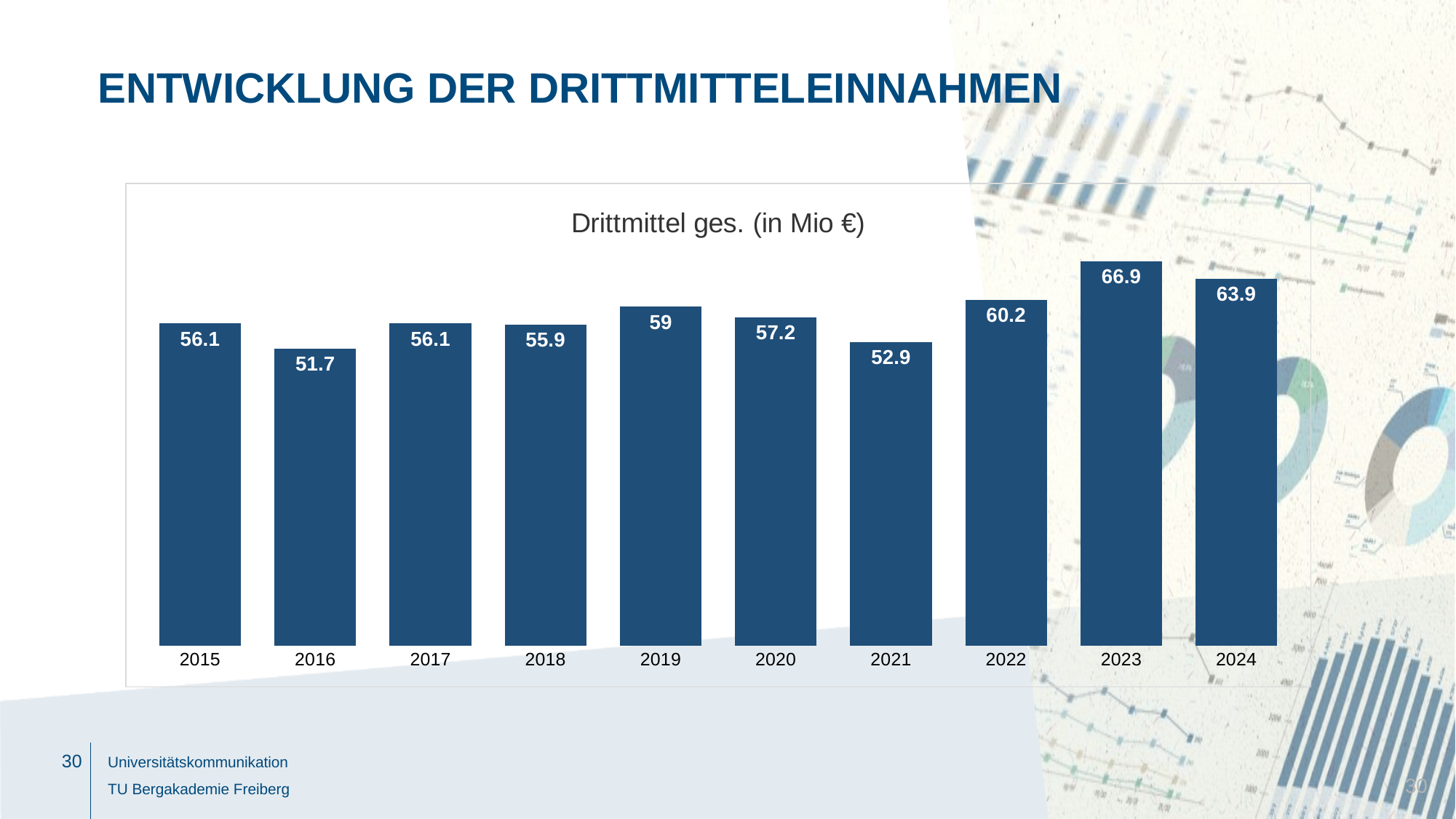
How many years are shown on the x axis? 10 Which year has the lowest value? 2016 Which year has the highest value? 2023 What kind of chart is shown? bar chart What is the value for 2016? 51.7 Do the values rise or fall from 2021 to 2023? rise What is the value for 2019? 59 What is the title of the chart? Drittmittel ges. (in Mio €) What is the value for 2024? 63.9 What is the difference between the values for 2023 and 2024? 3 What is the difference between the values for 2022 and 2021? 7.3 Which is larger, the value for 2020 or the value for 2018? 2020